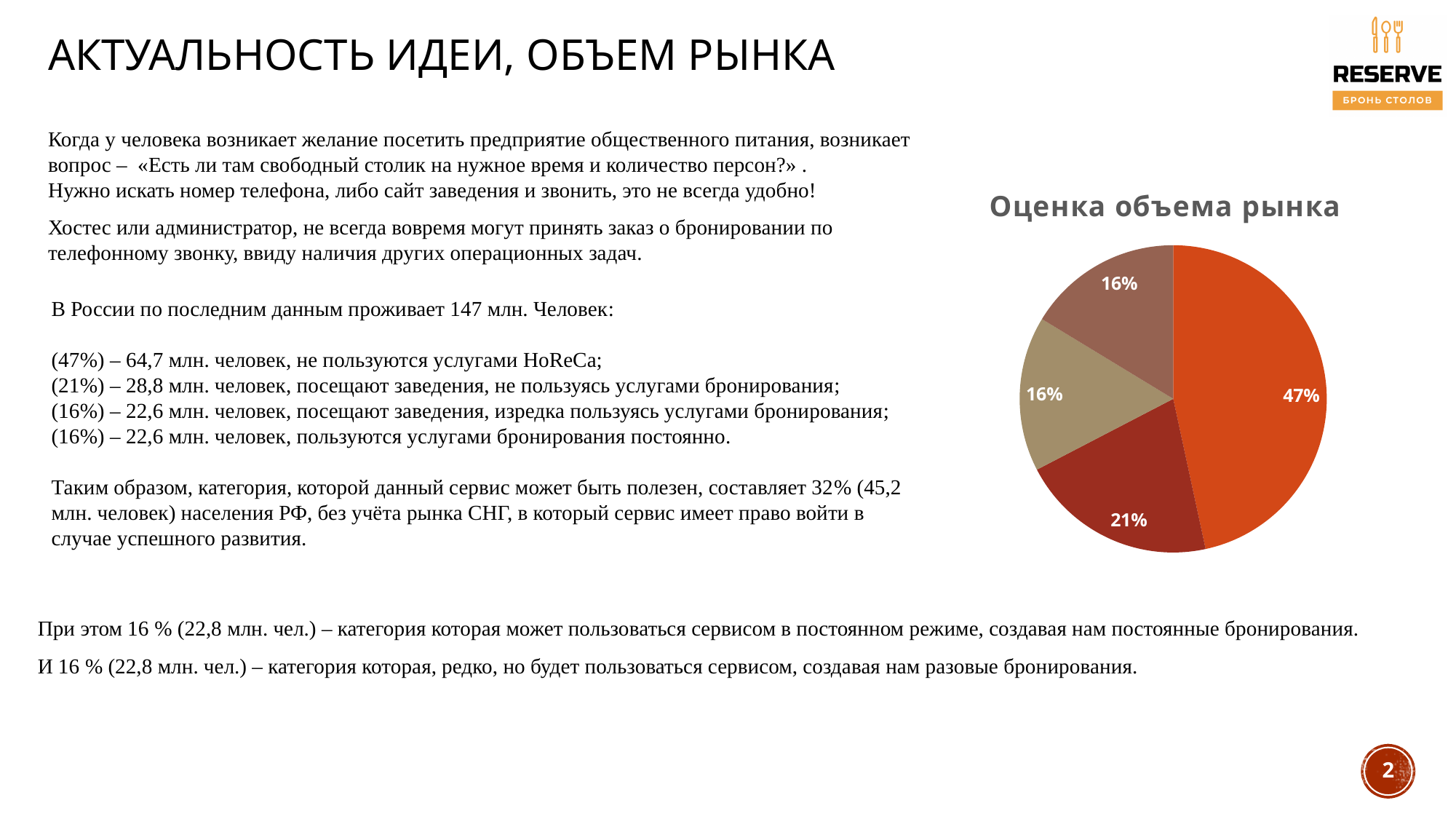
What is the share of the dark red slice at the bottom of the pie chart? 21% What is the combined share of the 47% and 21% slices? 68% What do the two 16% slices add up to? 32% Does the pie chart show a legend? No How many slices does the pie chart have? 4 What is the share of the largest slice in the pie chart? 47% What is the difference between the largest slice (47%) and the 21% slice? 26% What is the share of the smallest slices in the pie chart? 16% Which is larger in the pie chart: the orange slice or the dark red slice? the orange slice (47%) What kind of chart is shown on the slide? pie chart How many slices in the pie chart are labelled 16%? 2 What is the title of the pie chart? Оценка объема рынка